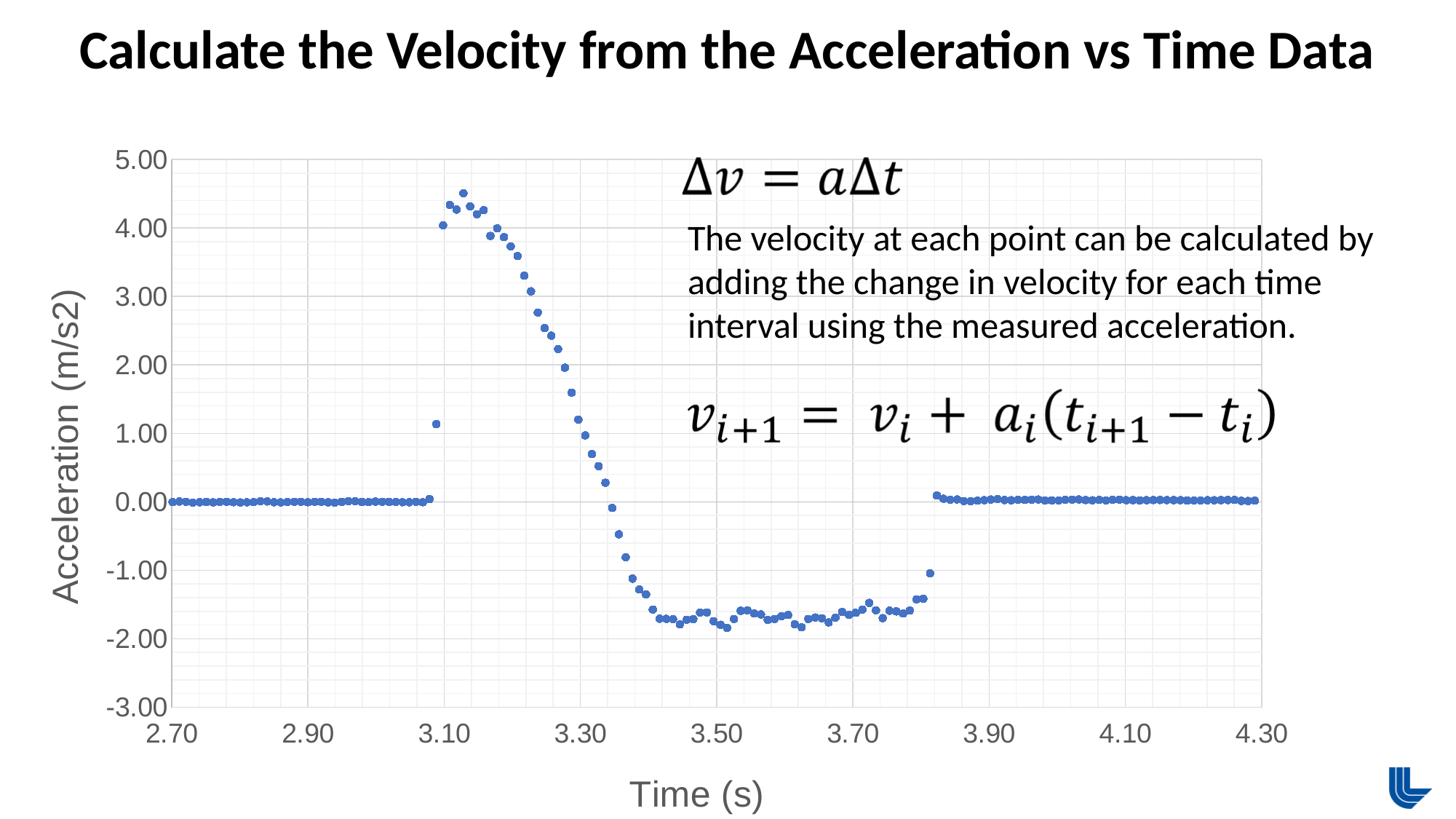
What is the highest value shown on the vertical axis of the chart? 5.00 Is the peak acceleration value on the chart greater or less than 5.00? less Is the lowest acceleration value on the chart greater or less than -2.00? greater Is the acceleration at time 2.90 s greater or less than 1.00? less Between time 3.10 and 3.40 s, do the acceleration values rise or fall along the x axis? fall What is the label of the horizontal axis of the chart? Time (s) Which is larger, the acceleration at time 3.10 s or the acceleration at time 3.50 s? 3.10 s What is the label of the vertical axis of the chart? Acceleration (m/s2) What kind of chart is shown on the slide? scatter chart